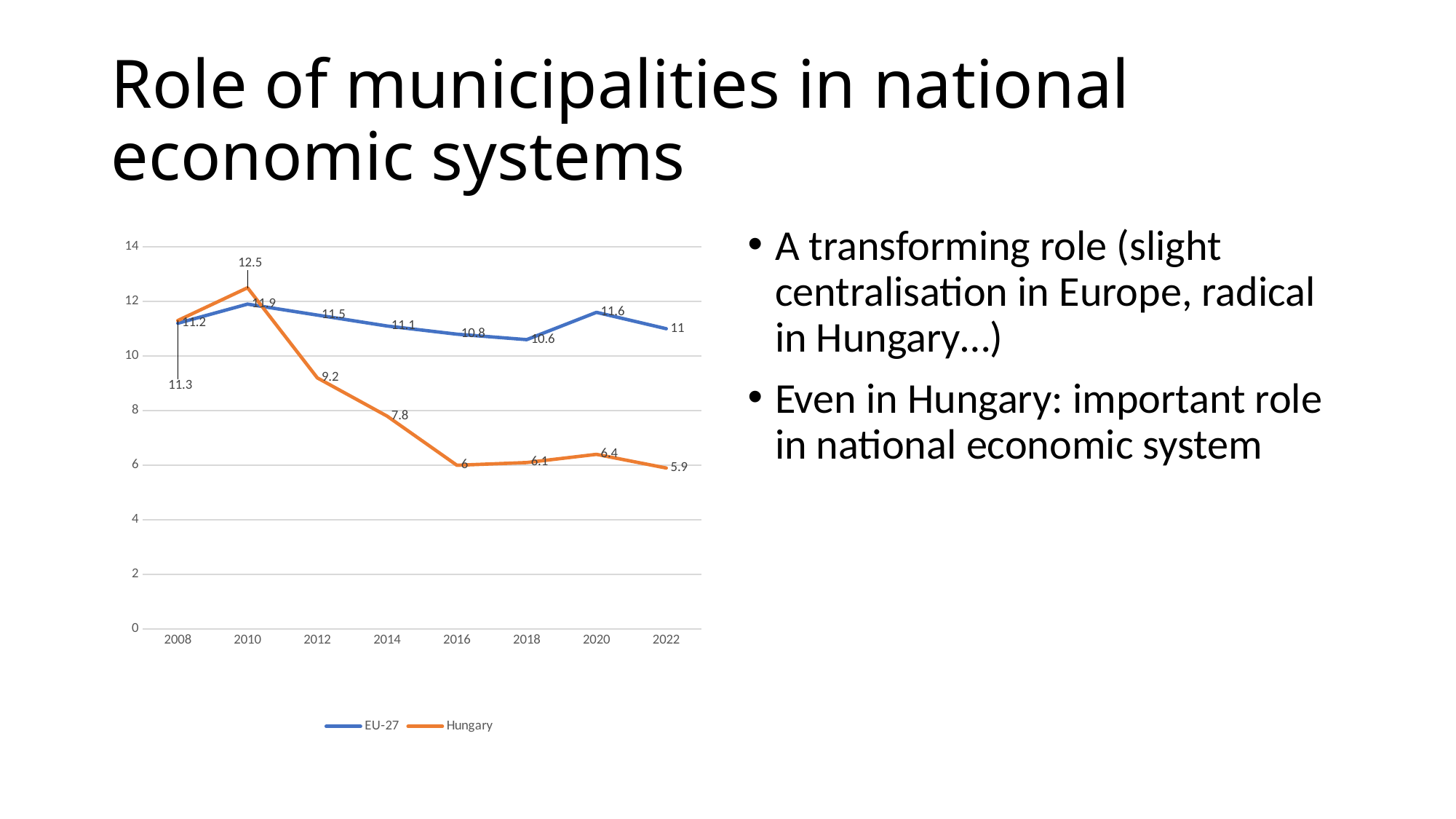
What is the value for Hungary in 2010? 12.5 Which series has the larger value in 2020, EU-27 or Hungary? EU-27 In which year does the Hungary series reach its highest value? 2010 What is the value for EU-27 in 2022? 11 Does the Hungary series rise or fall from 2010 to 2016? Fall What kind of chart is shown on the slide? Line chart How many series does the legend list? 2 How many years are plotted along the x axis? 8 What is the difference between the Hungary values in 2010 and 2022? 6.6 What is the value for EU-27 in 2018? 10.6 In which year does the EU-27 series reach its highest value? 2010 What is the value for Hungary in 2016? 6